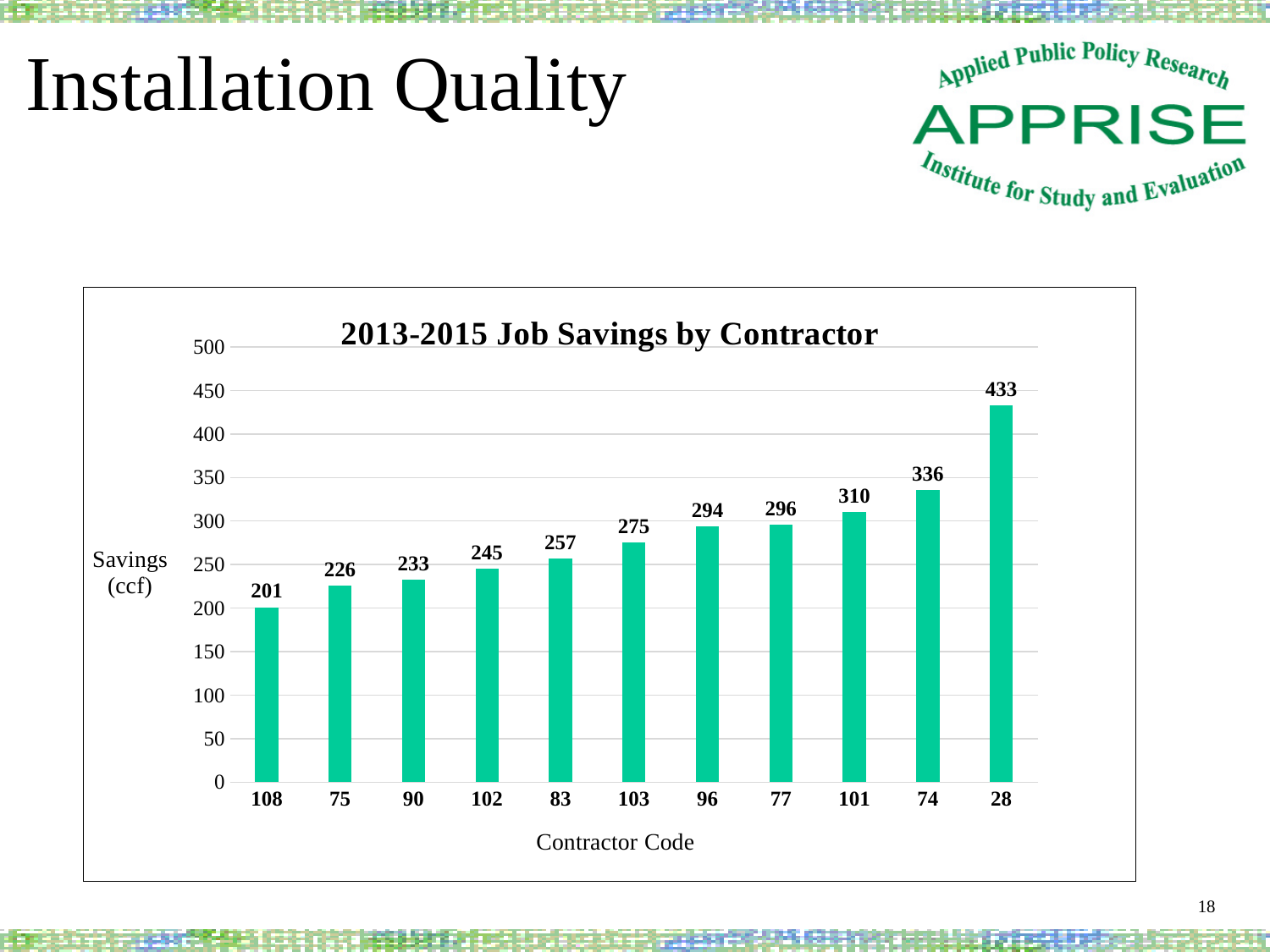
Which contractor code has the highest savings? 28 Which has higher savings, contractor code 83 or contractor code 90? 83 What is the savings value for contractor code 74? 336 What is the title of the chart? 2013-2015 Job Savings by Contractor What is the difference in savings between contractor code 101 and contractor code 108? 109 Is the savings value for contractor code 77 greater or less than 250? greater What kind of chart is shown on the slide? bar chart What is the savings value for contractor code 103? 275 Which contractor code has the lowest savings? 108 What is the savings value for contractor code 108? 201 How many contractor codes are shown on the chart? 11 What is the difference in savings between contractor code 28 and contractor code 74? 97